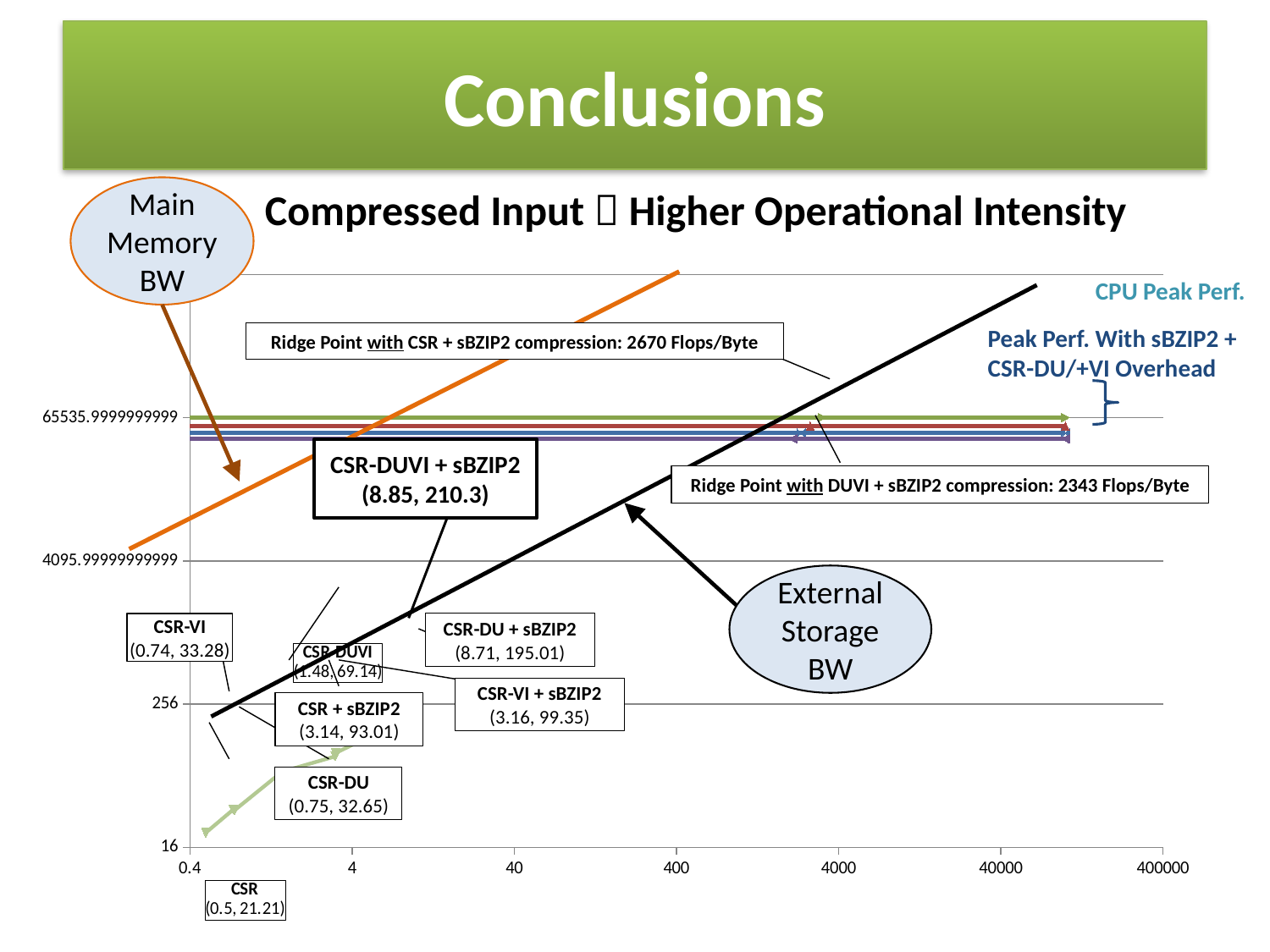
What kind of chart is shown on the slide? Line chart (roofline plot with log-log axes) Which has the larger second coordinate, CSR-VI + sBZIP2 or CSR + sBZIP2? CSR-VI + sBZIP2 What are the coordinates labelled for the CSR-VI + sBZIP2 point? (3.16, 99.35) Which labelled data point has the lowest second coordinate (performance value)? CSR How many labelled data points with coordinates are shown on the chart? 8 Which labelled data point has the highest second coordinate (performance value)? CSR-DUVI + sBZIP2 What is the ridge point value given for DUVI + sBZIP2 compression? 2343 Flops/Byte What are the coordinates labelled for the CSR-DU + sBZIP2 point? (8.71, 195.01) What is the difference between the second coordinates of CSR-DUVI + sBZIP2 (210.3) and CSR-DU + sBZIP2 (195.01)? 15.29 What are the coordinates labelled for the CSR-DUVI + sBZIP2 point? (8.85, 210.3) What is the ridge point value given for CSR + sBZIP2 compression? 2670 Flops/Byte What are the coordinates labelled for the CSR point? (0.5, 21.21)